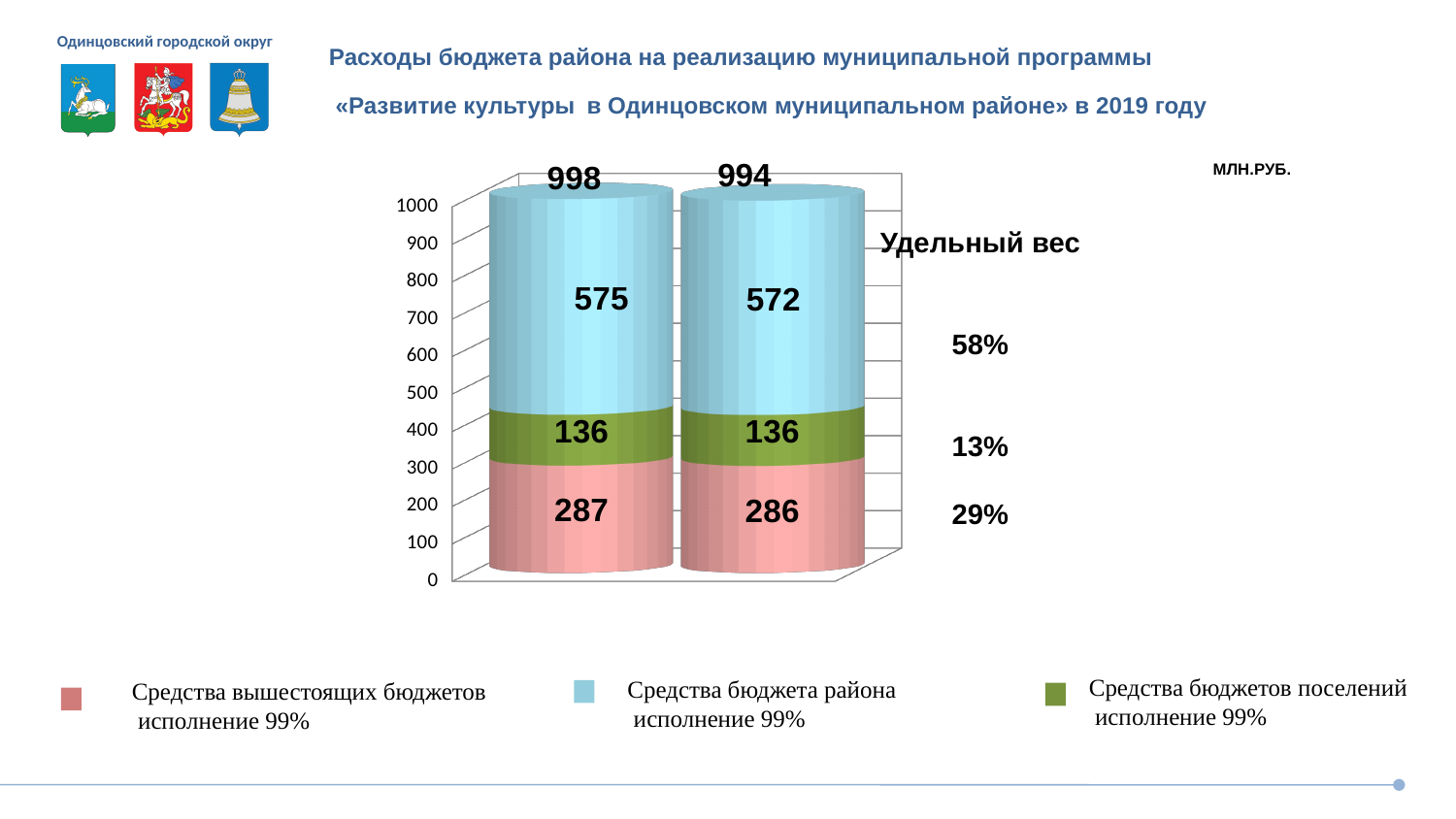
Which segment is larger in the left bar: 'Средства вышестоящих бюджетов' or 'Средства бюджетов поселений'? Средства вышестоящих бюджетов How many bars are plotted in the chart? 2 What type of chart is shown on the slide? bar chart How many series does the legend list? 3 What is the value of the 'Средства бюджетов поселений' (green) segment in the left bar? 136 What is the value of the 'Средства бюджета района' (blue) segment in the right bar? 572 What is the difference between the 'Средства бюджета района' values of the left bar and the right bar? 3 What is the value of the 'Средства вышестоящих бюджетов' (pink) segment in the right bar? 286 What is the total value labelled above the left bar? 998 What unit is indicated for the chart values? МЛН.РУБ. What is the total value labelled above the right bar? 994 What is the value of the 'Средства бюджета района' (blue) segment in the left bar? 575